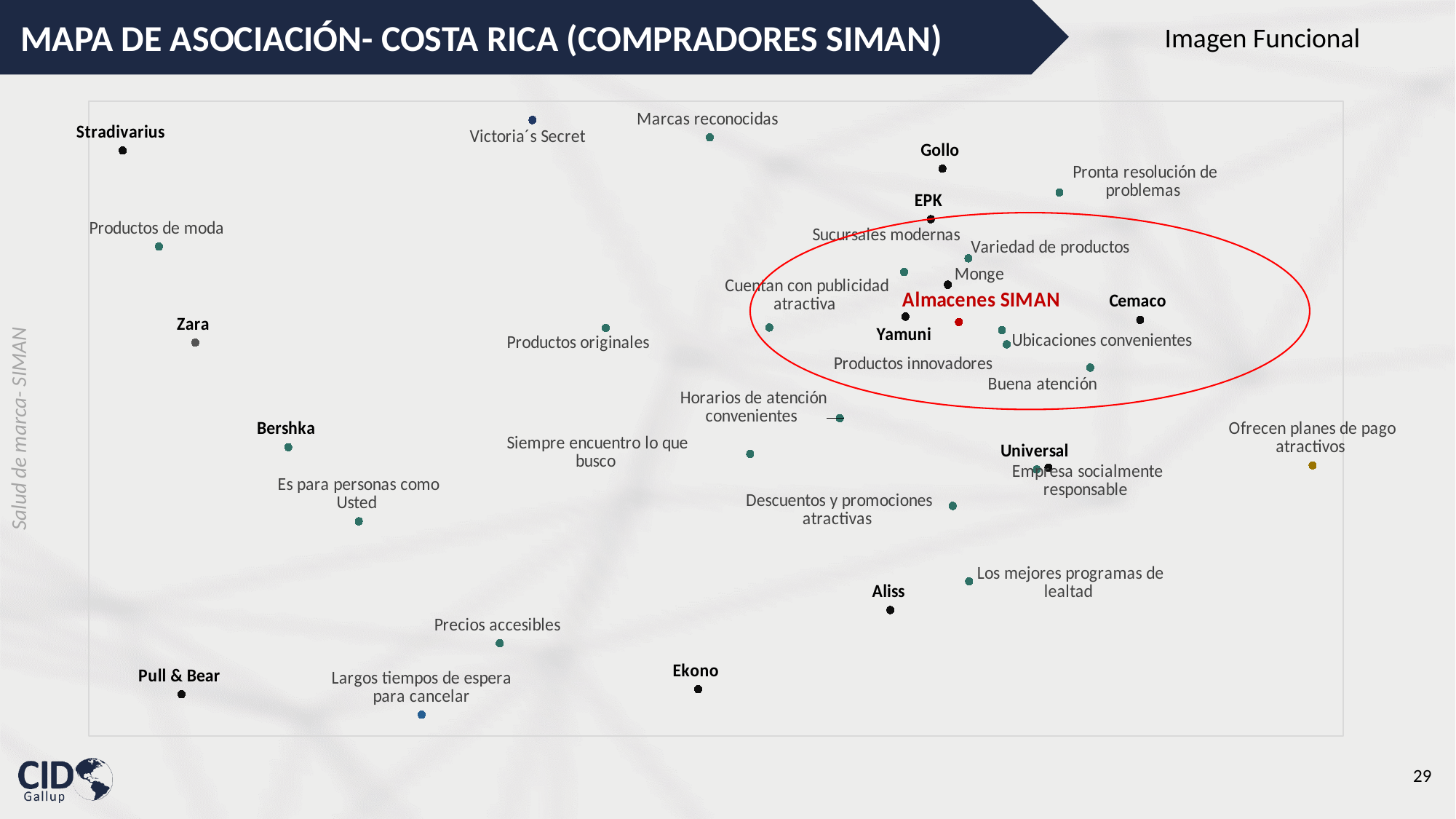
Which attribute is plotted nearest to Pull & Bear? Largos tiempos de espera para cancelar What is the title of the chart? MAPA DE ASOCIACIÓN- COSTA RICA (COMPRADORES SIMAN) Which brand is plotted closest to Almacenes SIMAN? Monge Which brand is plotted nearest to 'Los mejores programas de lealtad'? Aliss Which brand is highlighted in red on the map? Almacenes SIMAN Which attribute is plotted furthest to the right on the map? Ofrecen planes de pago atractivos Which point is plotted highest on the map? Victoria´s Secret Which point is plotted furthest to the left on the map? Stradivarius How many brands are plotted on the map? 14 Which brands fall inside the red ellipse? Monge, Almacenes SIMAN, Yamuni, Cemaco What kind of chart is shown on the slide? Scatter chart (association map) Which point is plotted lowest on the map? Largos tiempos de espera para cancelar